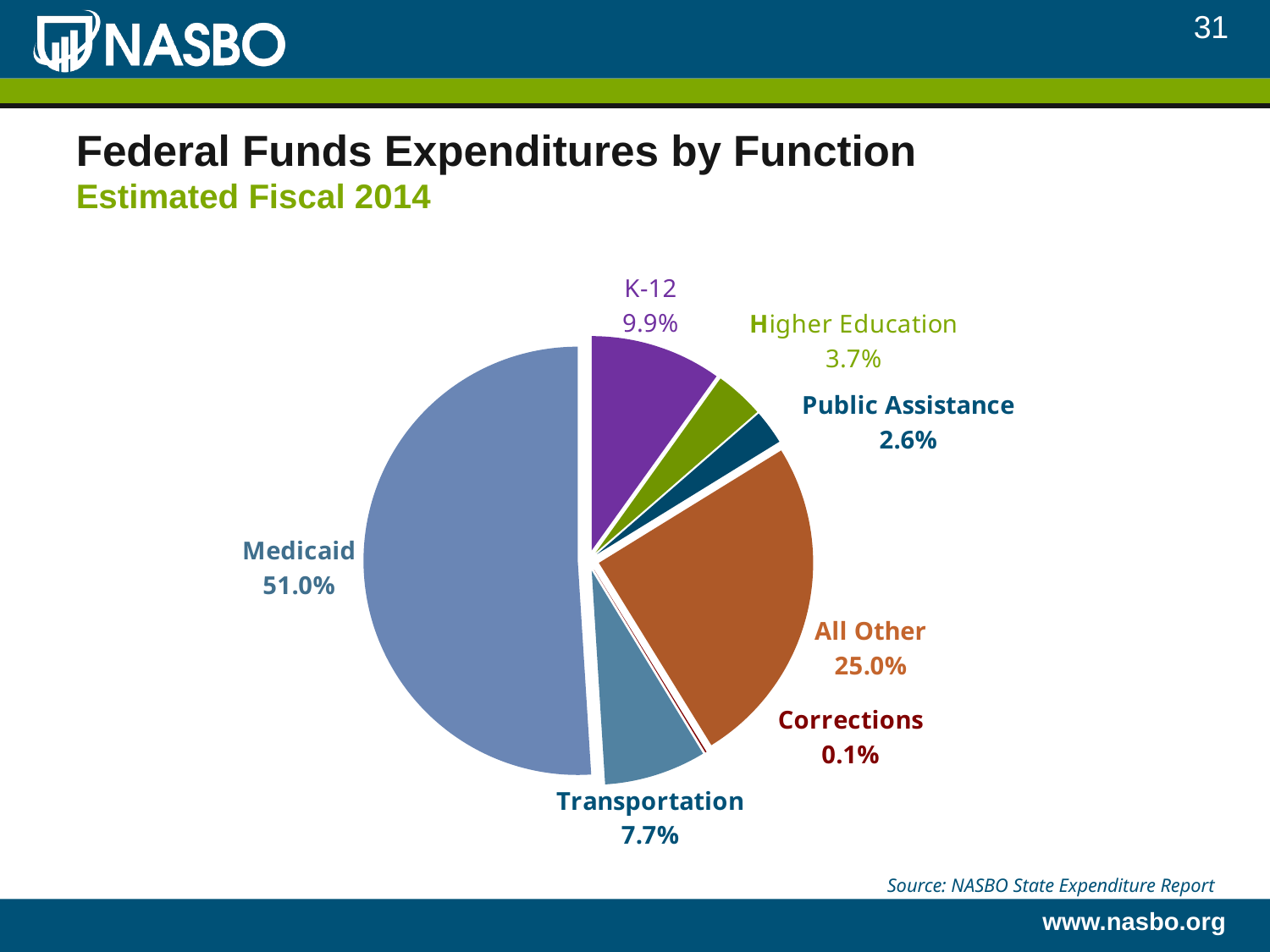
Which is larger, the share for Public Assistance or the share for Higher Education? Higher Education Which function has the smallest share of federal funds expenditures? Corrections What share of federal funds expenditures goes to Medicaid? 51.0% What kind of chart is shown on the slide? Pie chart What is the difference between the K-12 share and the Transportation share, in percentage points? 2.2 How many percentage points larger is the Medicaid share than the All Other share? 26.0 What percentage is shown for Higher Education? 3.7% What is the value for Transportation? 7.7% What fiscal year does the chart cover? Estimated Fiscal 2014 What percentage is shown for K-12? 9.9% Which function has the largest share of federal funds expenditures? Medicaid How many functions (slices) are shown in the pie chart? 7